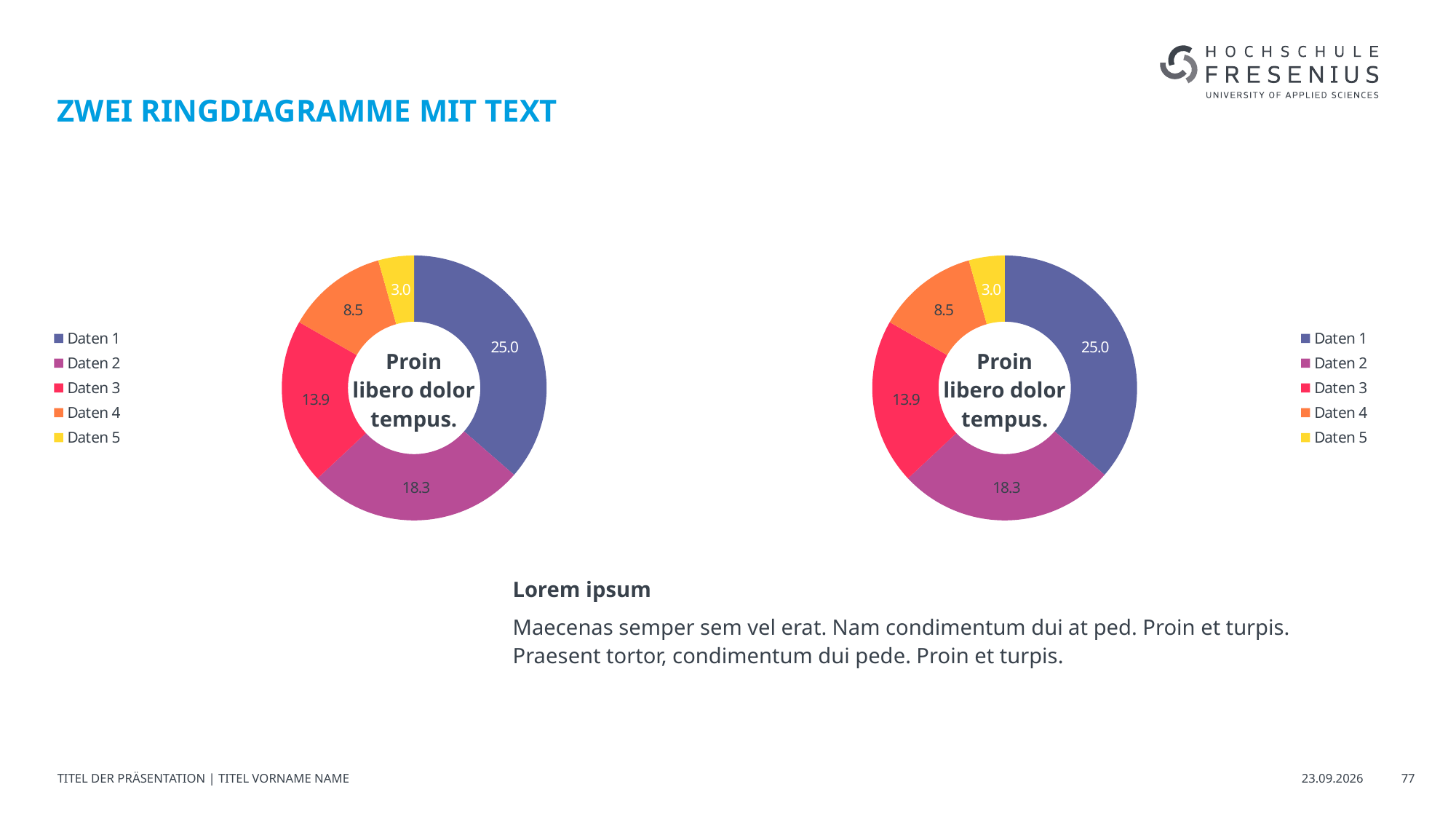
On the right chart, what is the value for Daten 4? 8.5 On the left chart, which category has the largest value? Daten 1 What kind of chart is the left chart? Doughnut chart How many categories does the right chart's legend list? 5 What text is shown in the centre of the right chart? Proin libero dolor tempus. On the right chart, what is the value for Daten 3? 13.9 On the left chart, which is larger, the value for Daten 2 or the value for Daten 3? Daten 2 On the right chart, what is the difference between the values for Daten 3 and Daten 4? 5.4 On the left chart, what is the value for Daten 5? 3.0 On the right chart, which category has the smallest value? Daten 5 On the left chart, what is the difference between the values for Daten 1 and Daten 2? 6.7 On the left chart, what is the value for Daten 1? 25.0